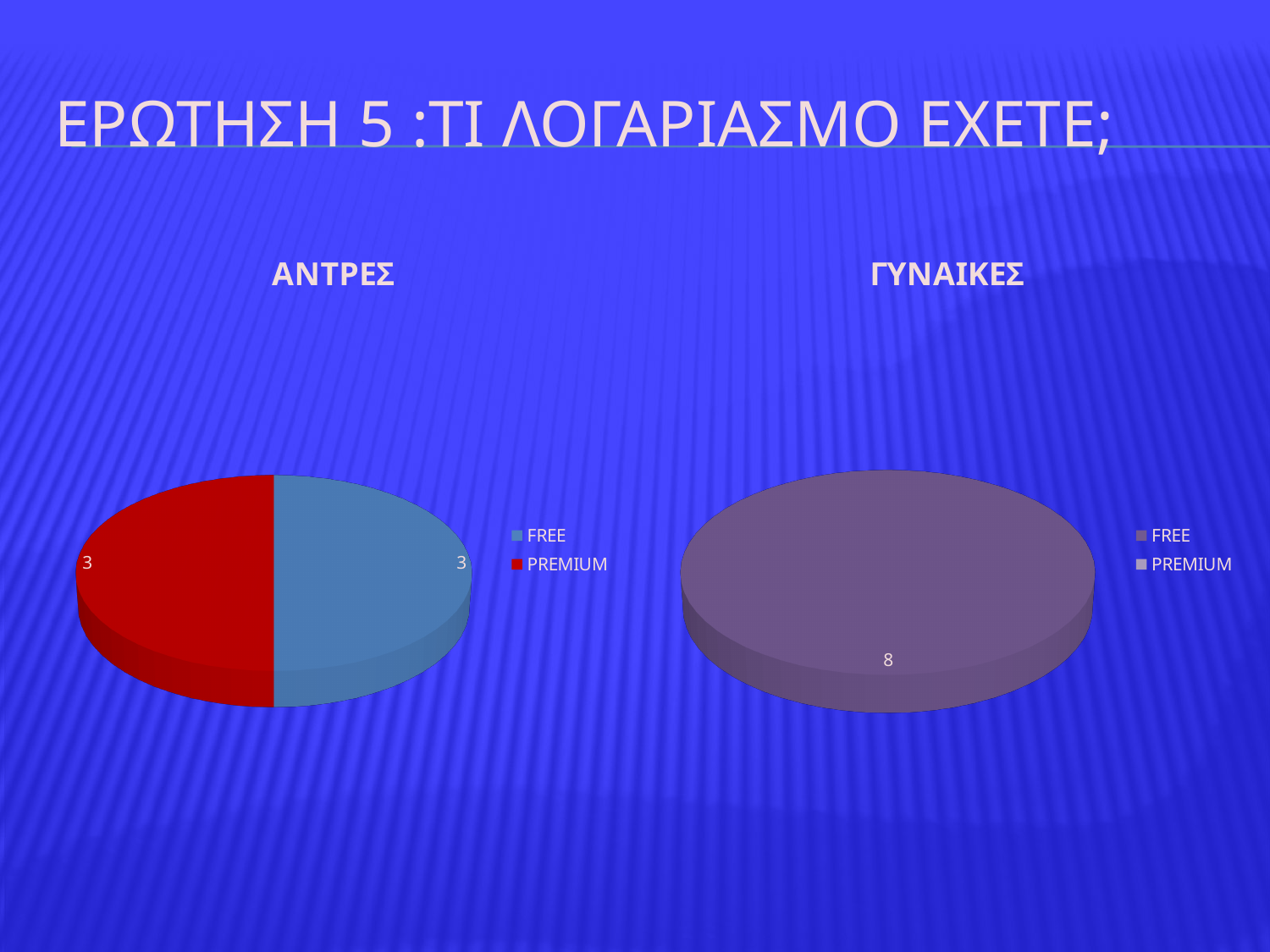
In the ΑΝΤΡΕΣ chart, which colour represents PREMIUM? Red In the ΑΝΤΡΕΣ chart, what is the value for PREMIUM? 3 In the ΑΝΤΡΕΣ chart, what is the value for FREE? 3 What kind of chart is the ΓΥΝΑΙΚΕΣ chart? Pie chart In the ΑΝΤΡΕΣ chart, what share of the pie does FREE take? 50% How many series does the legend of the ΓΥΝΑΙΚΕΣ chart list? 2 What is the title of the chart on the right? ΓΥΝΑΙΚΕΣ How many series does the legend of the ΑΝΤΡΕΣ chart list? 2 In the ΑΝΤΡΕΣ chart, what is the difference between the FREE and PREMIUM values? 0 How many slices are visible in the ΑΝΤΡΕΣ pie chart? 2 What kind of chart is the ΑΝΤΡΕΣ chart? Pie chart What is the only data label shown on the ΓΥΝΑΙΚΕΣ chart? 8